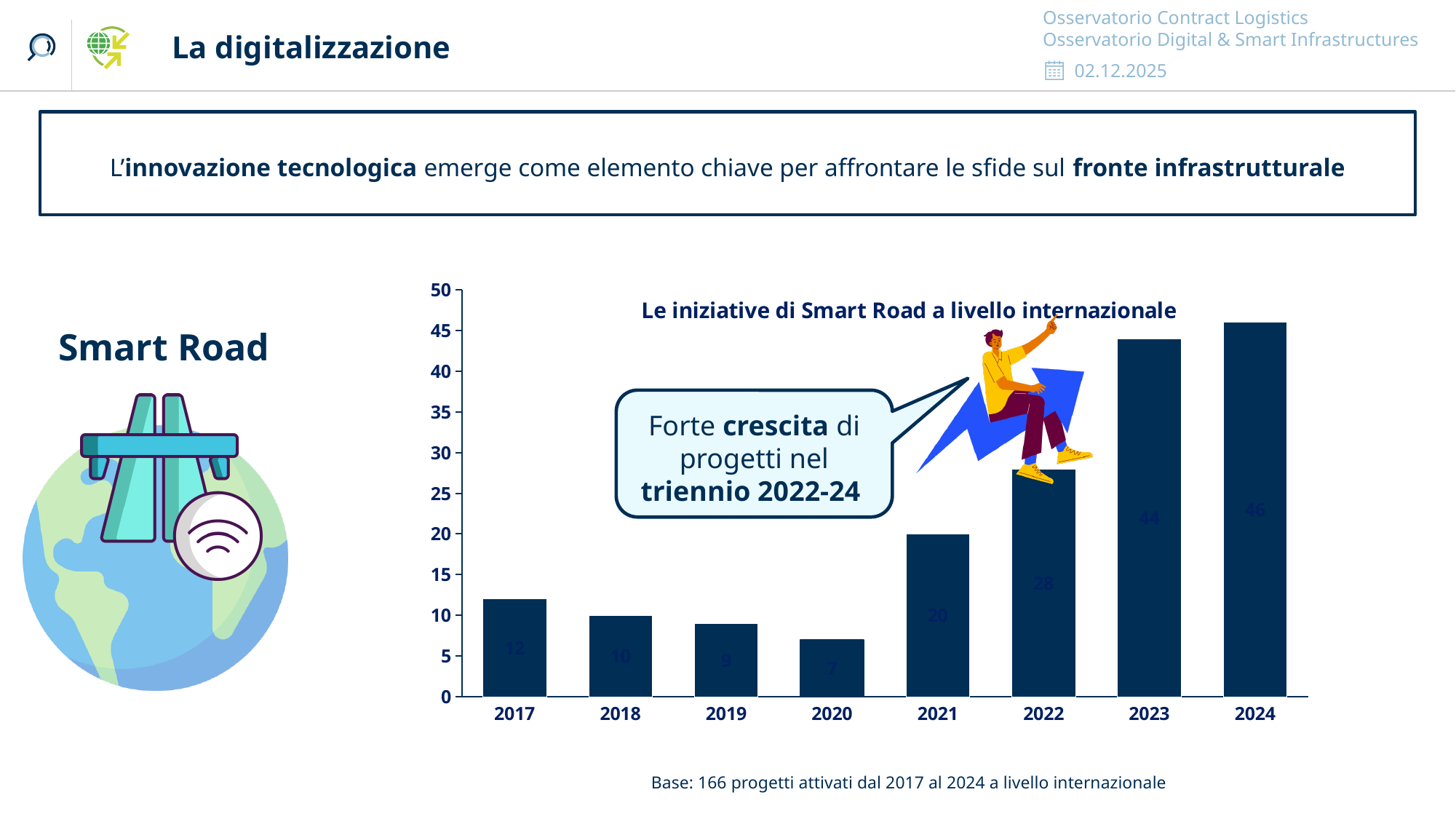
What is the value for 2022? 28 Which year has the lowest value? 2020 Which is larger, the value for 2018 or the value for 2021? 2021 Which year has the highest value? 2024 What type of chart is shown on the slide? bar chart What is the value for 2024? 46 Do the values rise or fall from 2020 to 2024? rise What is the value for 2017? 12 What is the title of the chart? Le iniziative di Smart Road a livello internazionale What is the value for 2020? 7 What is the difference between the values for 2023 and 2022? 16 How many years are shown on the x axis of the chart? 8